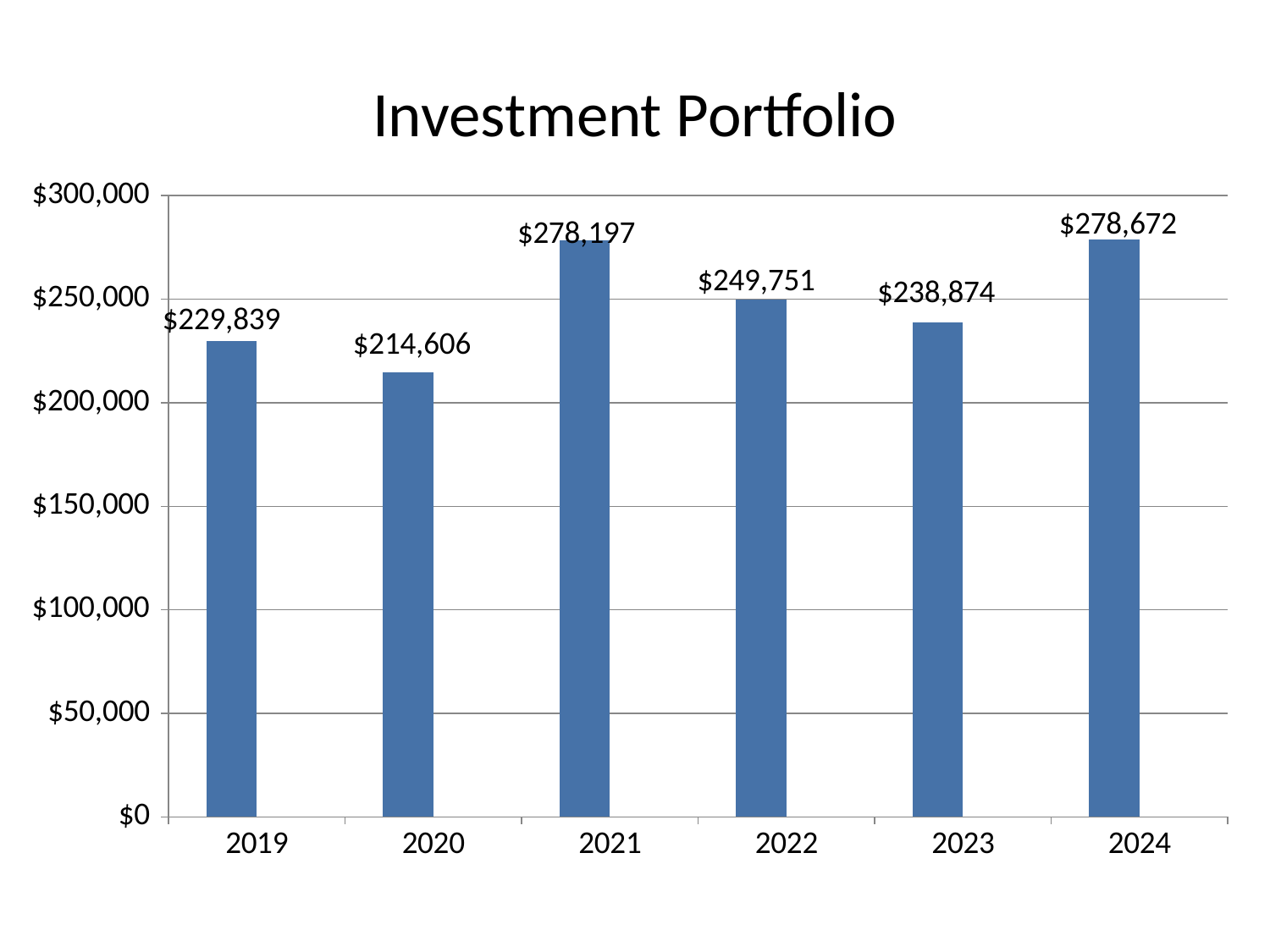
What is the difference between the portfolio values in 2024 and 2020? $64,066 Which year has the lowest investment portfolio value? 2020 What is the title of the chart? Investment Portfolio What type of chart is shown on the slide? bar chart What is the value of the investment portfolio in 2019? $229,839 What is the difference between the portfolio values in 2022 and 2023? $10,877 What is the value of the investment portfolio in 2021? $278,197 How many years are shown on the chart? 6 What is the value of the investment portfolio in 2023? $238,874 Is the value for 2024 greater or less than $250,000? greater Which year has a larger portfolio value, 2019 or 2022? 2022 Is the value for 2020 greater or less than $250,000? less